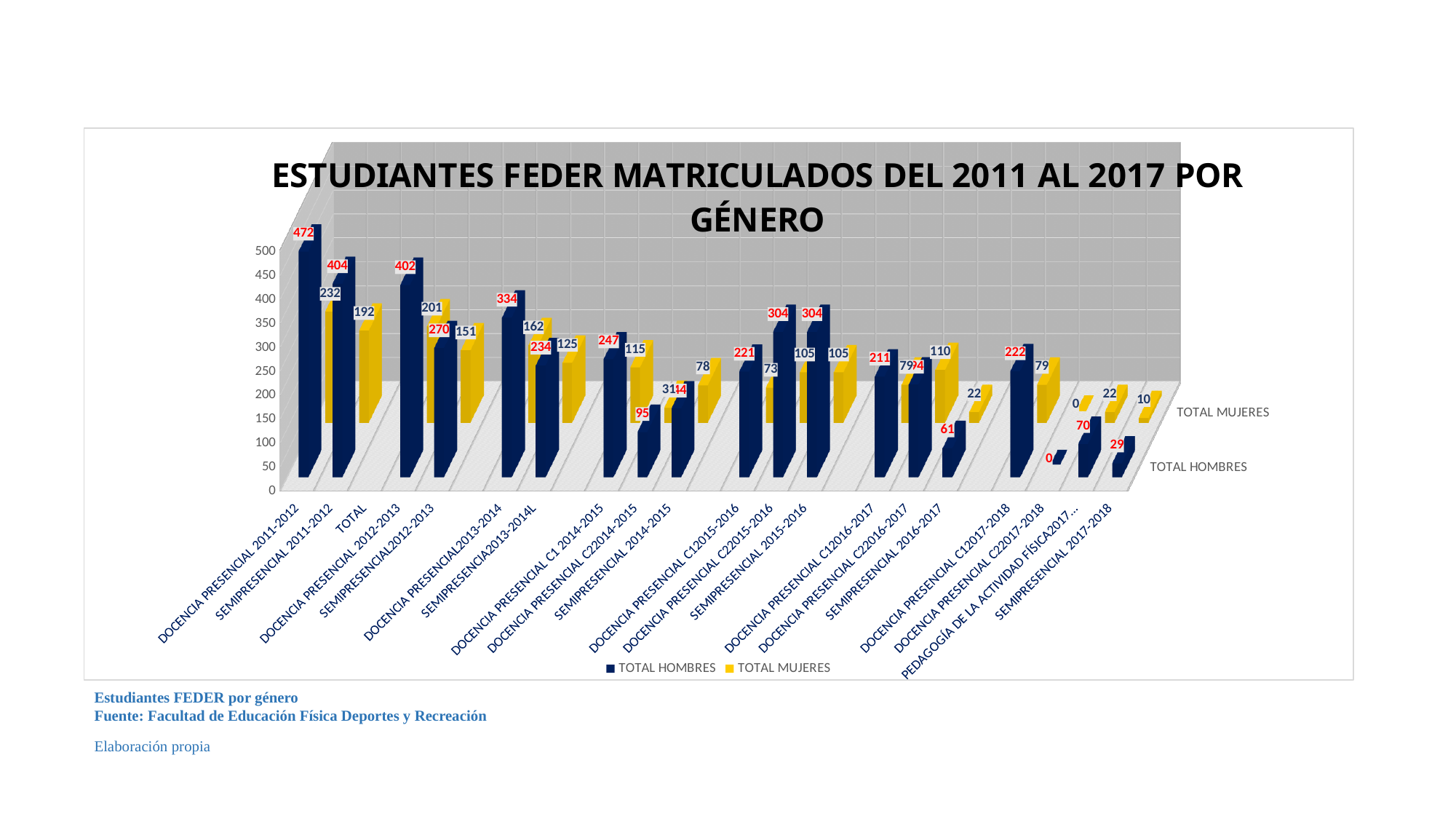
What is the TOTAL HOMBRES value for SEMIPRESENCIAL 2011-2012? 404 How many series does the legend list? 2 Which category has the highest TOTAL MUJERES value? DOCENCIA PRESENCIAL 2011-2012 Is the TOTAL HOMBRES value for SEMIPRESENCIAL 2011-2012 greater or less than 350? greater Which category has the highest TOTAL HOMBRES value? DOCENCIA PRESENCIAL 2011-2012 For DOCENCIA PRESENCIAL 2011-2012, which is larger, TOTAL HOMBRES or TOTAL MUJERES? TOTAL HOMBRES What is the TOTAL MUJERES value for DOCENCIA PRESENCIAL 2011-2012? 232 What is the difference between TOTAL HOMBRES and TOTAL MUJERES for DOCENCIA PRESENCIAL 2011-2012? 240 What is the TOTAL HOMBRES value for DOCENCIA PRESENCIAL 2011-2012? 472 What kind of chart is shown on the slide? bar chart Which series is shown in yellow? TOTAL MUJERES What is the title of the chart? ESTUDIANTES FEDER MATRICULADOS DEL 2011 AL 2017 POR GÉNERO